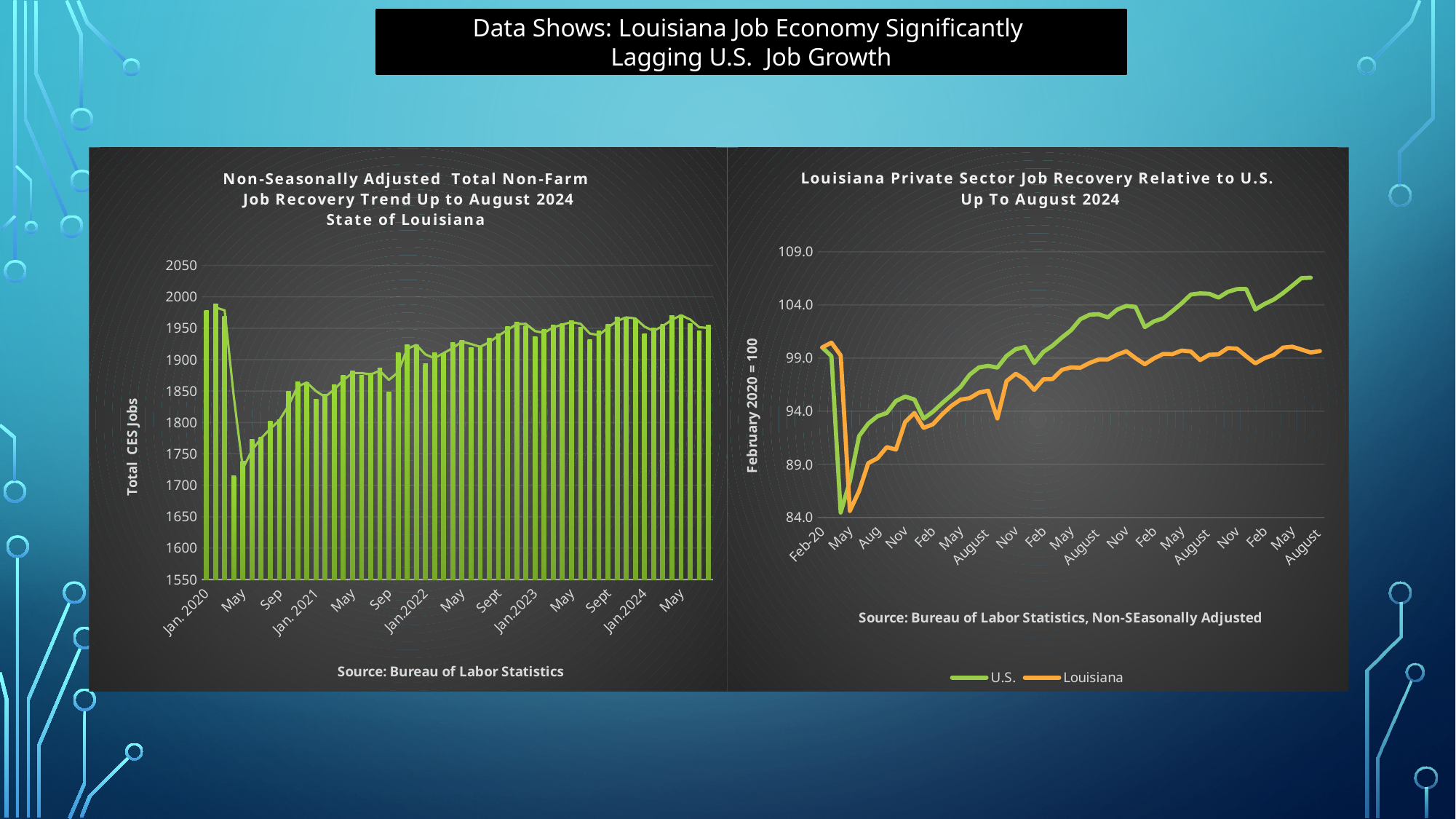
In the right chart, which series is higher at the final point (August 2024): U.S. or Louisiana? U.S. In the right chart, do the U.S. and Louisiana lines generally rise or fall from mid-2020 to August 2024? Rise How many series does the legend of the right chart list? 2 What is the y-axis label of the left chart? Total CES Jobs What kind of chart is the right chart, 'Louisiana Private Sector Job Recovery Relative to U.S. Up To August 2024'? Line chart What kind of chart is the left chart, 'Non-Seasonally Adjusted Total Non-Farm Job Recovery Trend Up to August 2024 State of Louisiana'? Bar chart In the right chart, is the lowest point of the Louisiana line greater or less than 89.0? less What is the y-axis label of the right chart? February 2020 = 100 In the left chart, is the lowest bar greater or less than 1750? less In the right chart, is the Louisiana value at the final point (August 2024) greater or less than 104.0? less